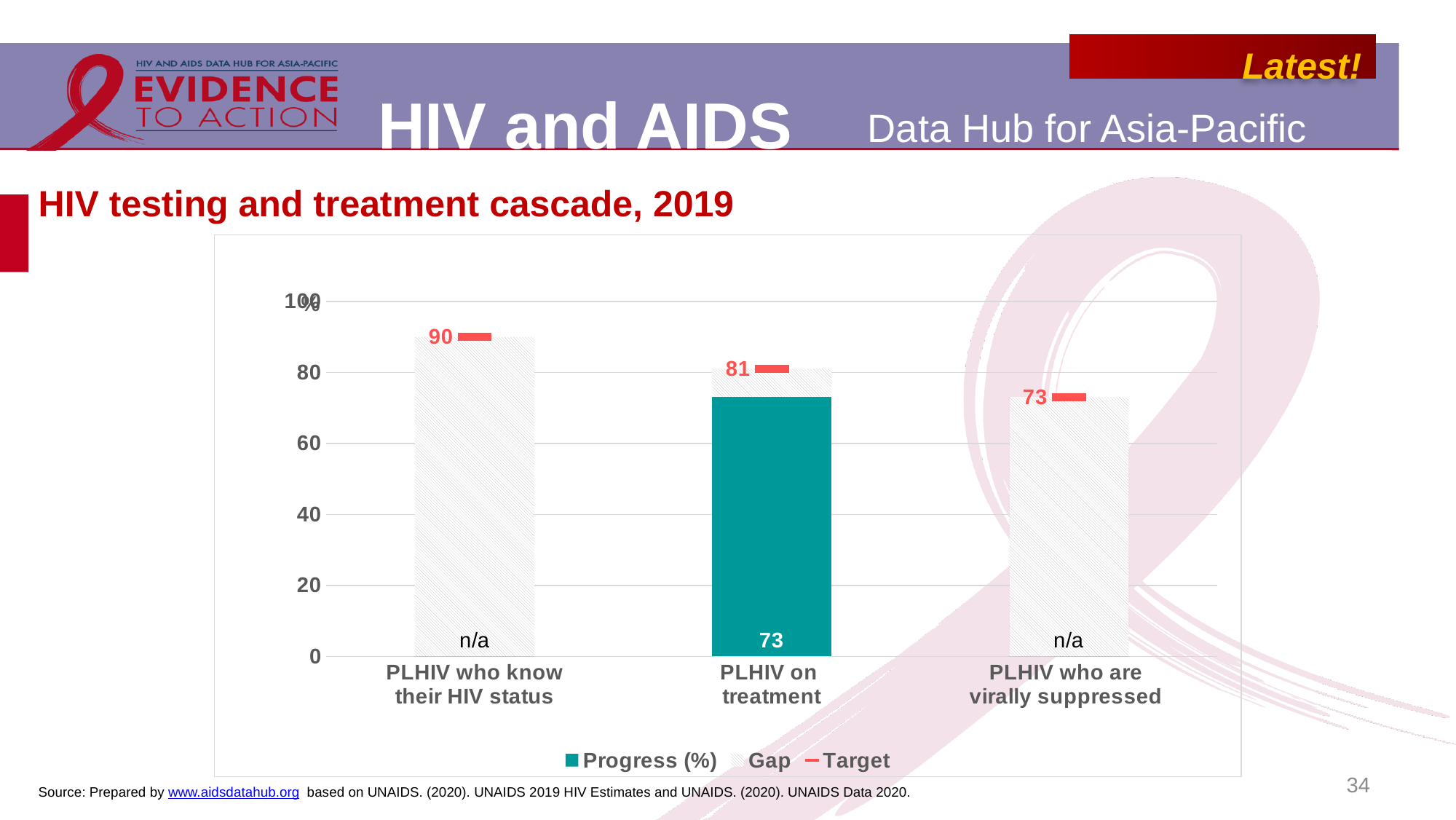
What kind of chart is shown on the slide? Bar chart What is the difference between the Target and the Progress (%) value for PLHIV on treatment? 8 How many series does the legend list? 3 What is the Target value for PLHIV on treatment? 81 Which category has the lowest Target value? PLHIV who are virally suppressed How many categories are shown on the x axis? 3 Which category has the highest Target value? PLHIV who know their HIV status What is the Target value for PLHIV who know their HIV status? 90 What Progress (%) value is shown for PLHIV who know their HIV status? n/a What is the Progress (%) value for PLHIV on treatment? 73 What is the difference between the Target values for PLHIV who know their HIV status and PLHIV on treatment? 9 What is the Target value for PLHIV who are virally suppressed? 73